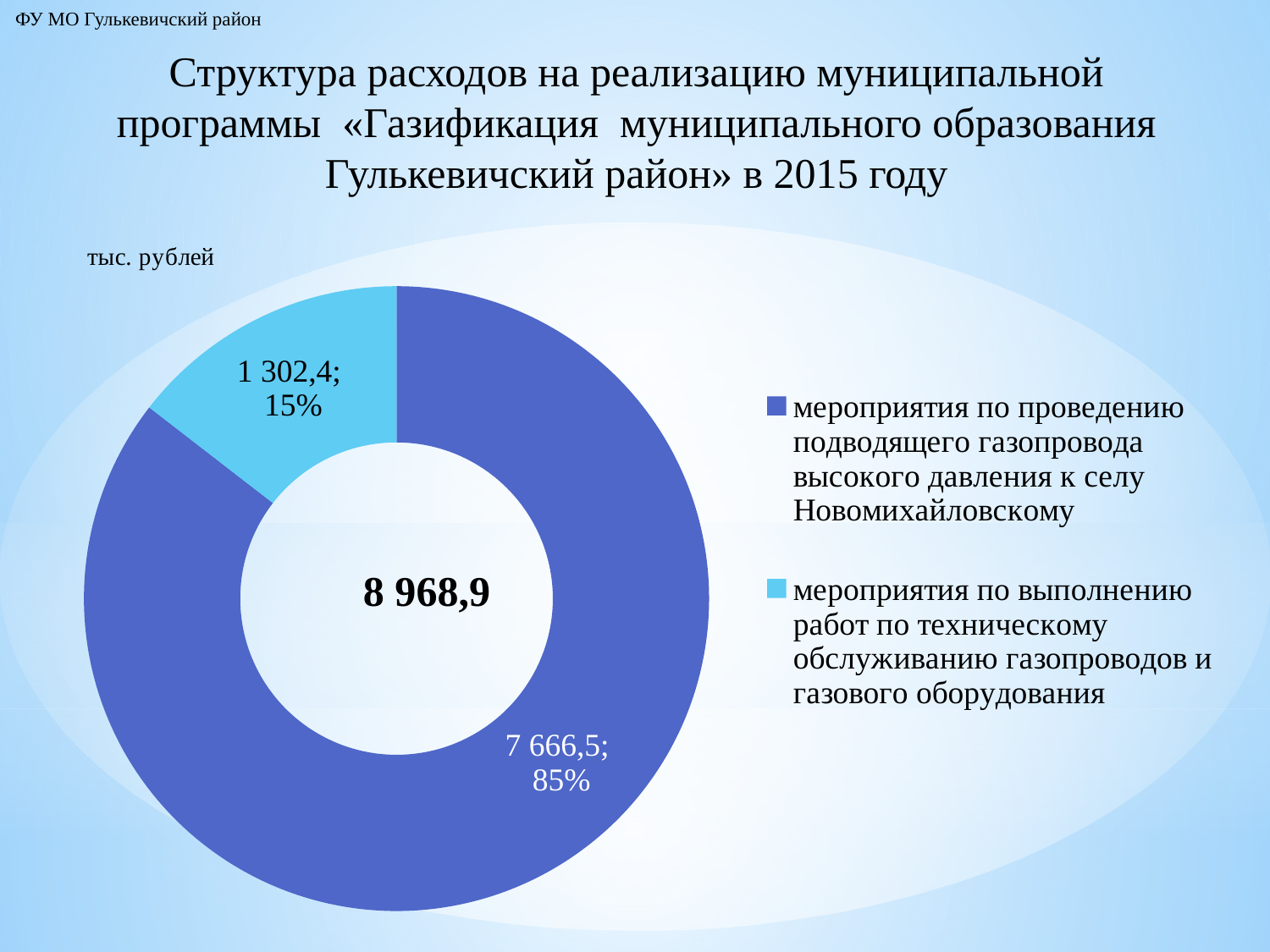
Which category has the largest share of the chart? мероприятия по проведению подводящего газопровода высокого давления к селу Новомихайловскому Which is larger: the value for мероприятия по проведению подводящего газопровода or the value for мероприятия по выполнению работ по техническому обслуживанию? мероприятия по проведению подводящего газопровода высокого давления к селу Новомихайловскому What share of the chart does мероприятия по выполнению работ по техническому обслуживанию газопроводов и газового оборудования represent? 15% What is the value for мероприятия по проведению подводящего газопровода высокого давления к селу Новомихайловскому? 7 666,5 What is the difference between the value for мероприятия по проведению подводящего газопровода and the value for мероприятия по выполнению работ по техническому обслуживанию? 6 364,1 What is the total value shown in the centre of the chart? 8 968,9 In what units are the chart values given? тыс. рублей How many categories does the chart show? 2 What kind of chart is shown on the slide? doughnut chart What is the value for мероприятия по выполнению работ по техническому обслуживанию газопроводов и газового оборудования? 1 302,4 What share of the chart does мероприятия по проведению подводящего газопровода высокого давления к селу Новомихайловскому represent? 85% Which category has the smallest share of the chart? мероприятия по выполнению работ по техническому обслуживанию газопроводов и газового оборудования